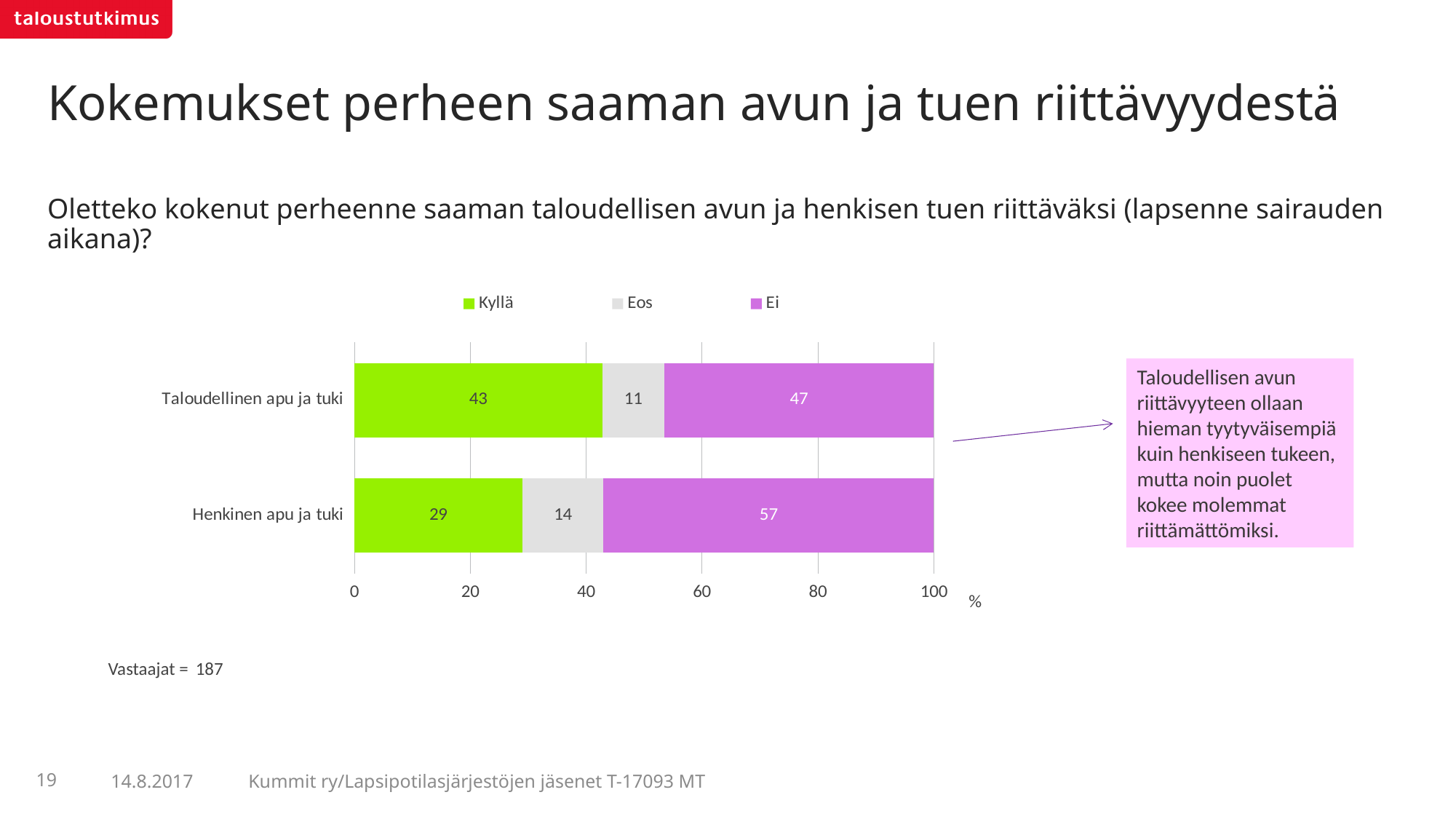
What is the "Eos" value for Henkinen apu ja tuki? 14 Which category has the higher "Kyllä" value? Taloudellinen apu ja tuki What percentage of respondents answered "Ei" for Henkinen apu ja tuki? 57 Is the "Kyllä" value for Henkinen apu ja tuki larger or smaller than the "Ei" value for the same category? smaller What is the total of the stacked bar for Taloudellinen apu ja tuki? 101 What kind of chart is shown on the slide? Stacked bar chart How many categories are shown on the chart? 2 How many series does the legend list? 3 What percentage of respondents answered "Kyllä" for Taloudellinen apu ja tuki? 43 Which category has the lower "Eos" value? Taloudellinen apu ja tuki What is the "Ei" value for Taloudellinen apu ja tuki? 47 What is the difference between the "Ei" values for Henkinen apu ja tuki and Taloudellinen apu ja tuki? 10